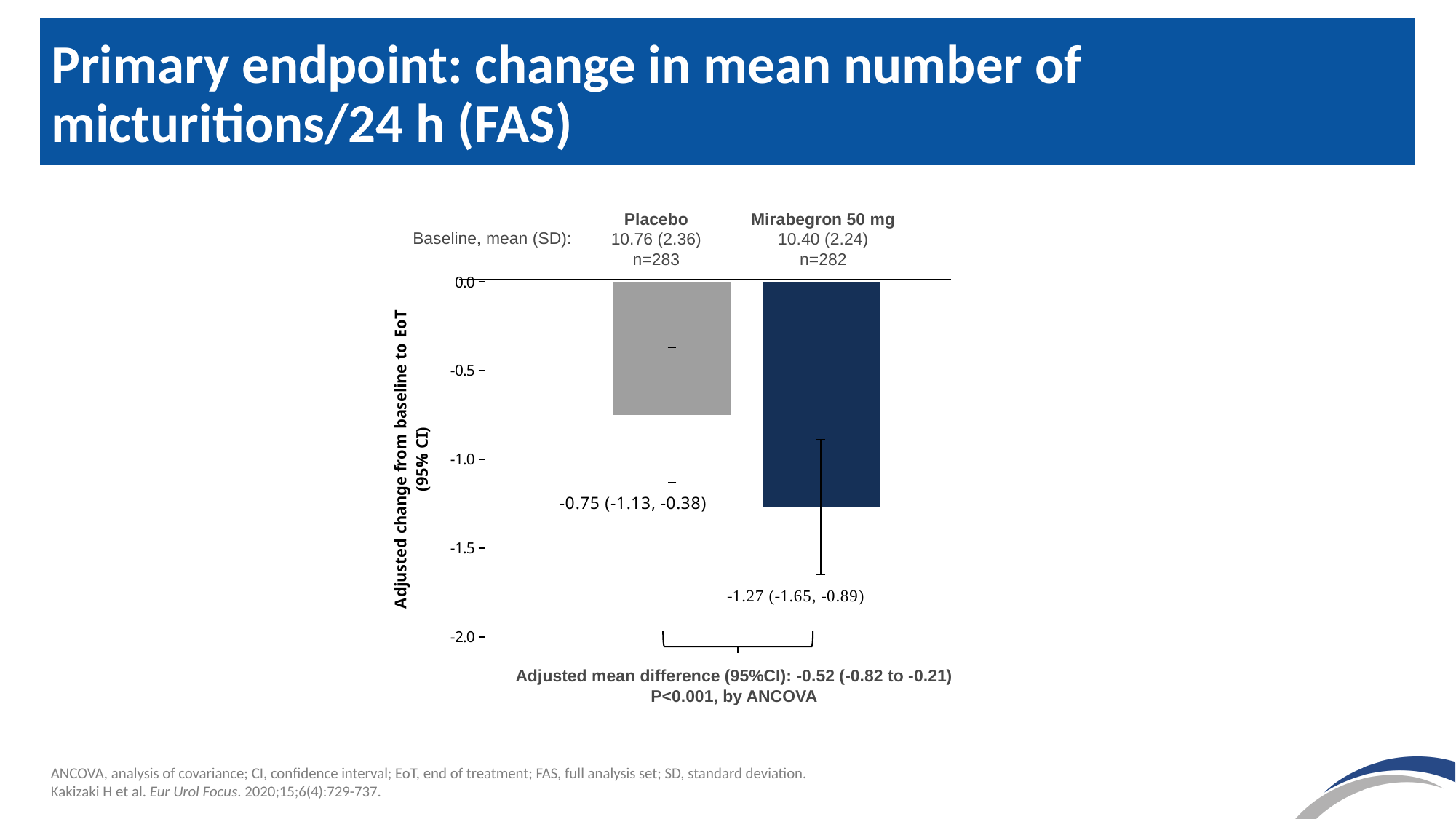
What is the baseline mean (SD) for the Placebo group? 10.76 (2.36) What is the adjusted change from baseline to EoT for the Mirabegron 50 mg group? -1.27 How many patients (n) are in the Mirabegron 50 mg group? n=282 What is the difference between the adjusted change values for Mirabegron 50 mg and Placebo? -0.52 Which group shows the larger reduction in mean number of micturitions/24 h, Placebo or Mirabegron 50 mg? Mirabegron 50 mg Which group has the lowest (most negative) adjusted change from baseline? Mirabegron 50 mg What type of chart is shown on the slide? Bar chart What is the 95% CI shown for the Placebo bar? (-1.13, -0.38) Is the adjusted change value for Mirabegron 50 mg greater or less than -1.0? less What is the 95% CI shown for the Mirabegron 50 mg bar? (-1.65, -0.89) What is the adjusted change from baseline to EoT for the Placebo group? -0.75 How many bars are plotted in the chart? 2